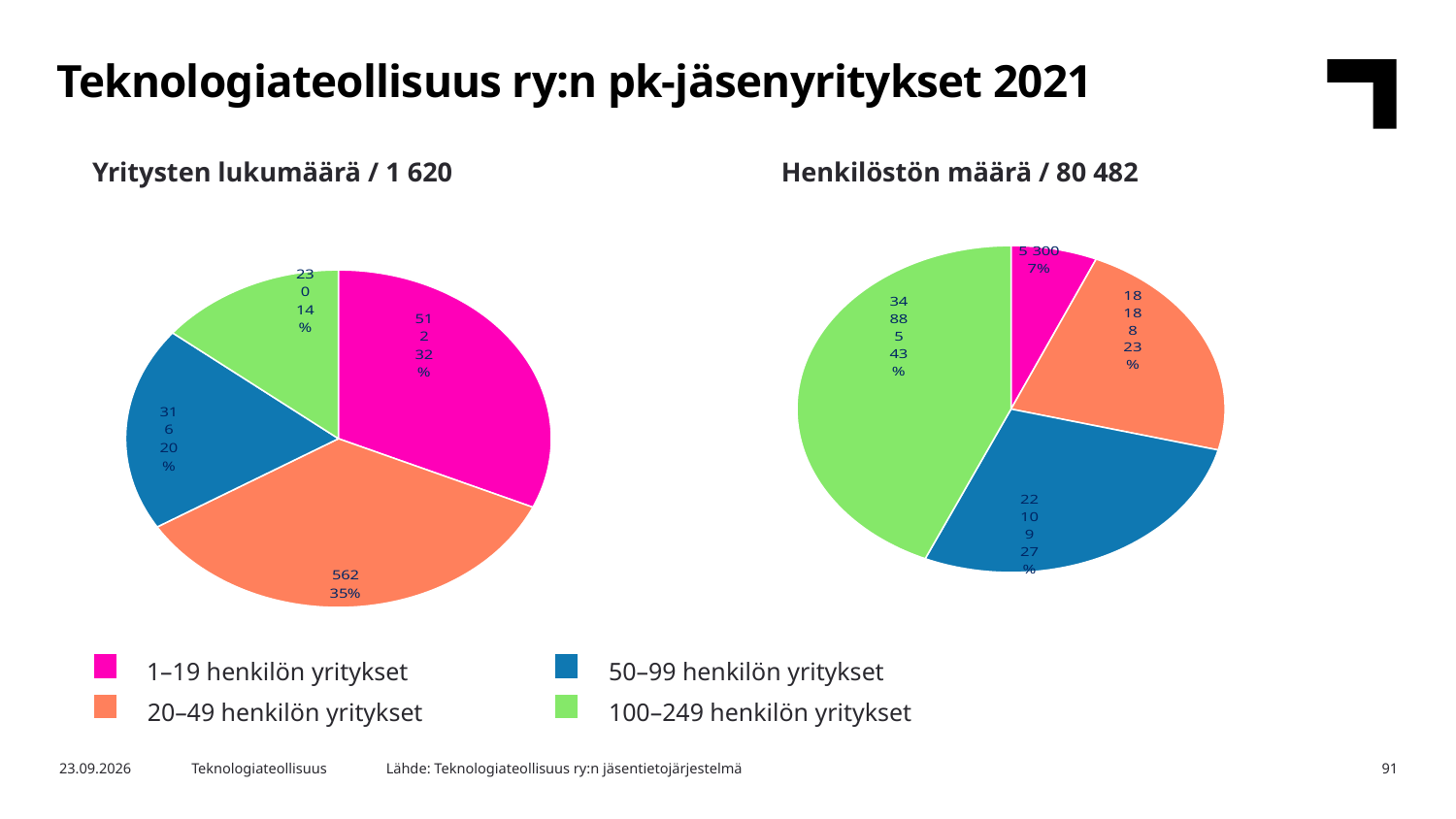
In the 'Henkilöstön määrä / 80 482' chart, what percentage share do the 100–249 henkilön yritykset have? 43% In the 'Henkilöstön määrä / 80 482' chart, which is larger: the slice for 50–99 henkilön yritykset or the slice for 20–49 henkilön yritykset? 50–99 henkilön yritykset In the 'Henkilöstön määrä / 80 482' chart, which category has the smallest slice? 1–19 henkilön yritykset What kind of chart is used on this slide? Pie chart In the 'Yritysten lukumäärä / 1 620' chart, what is the difference in percentage points between the 20–49 and 1–19 henkilön yritykset slices? 3 percentage points How many series does the legend list? 4 In the 'Yritysten lukumäärä / 1 620' chart, what is the value for 20–49 henkilön yritykset? 562 In the 'Yritysten lukumäärä / 1 620' chart, what percentage share do the 20–49 henkilön yritykset have? 35% In the 'Henkilöstön määrä / 80 482' chart, what is the value for 1–19 henkilön yritykset? 5 300 In the 'Yritysten lukumäärä / 1 620' chart, which category has the smallest slice? 100–249 henkilön yritykset Which colour represents 100–249 henkilön yritykset in the legend? Green In the 'Yritysten lukumäärä / 1 620' chart, which category has the largest slice? 20–49 henkilön yritykset